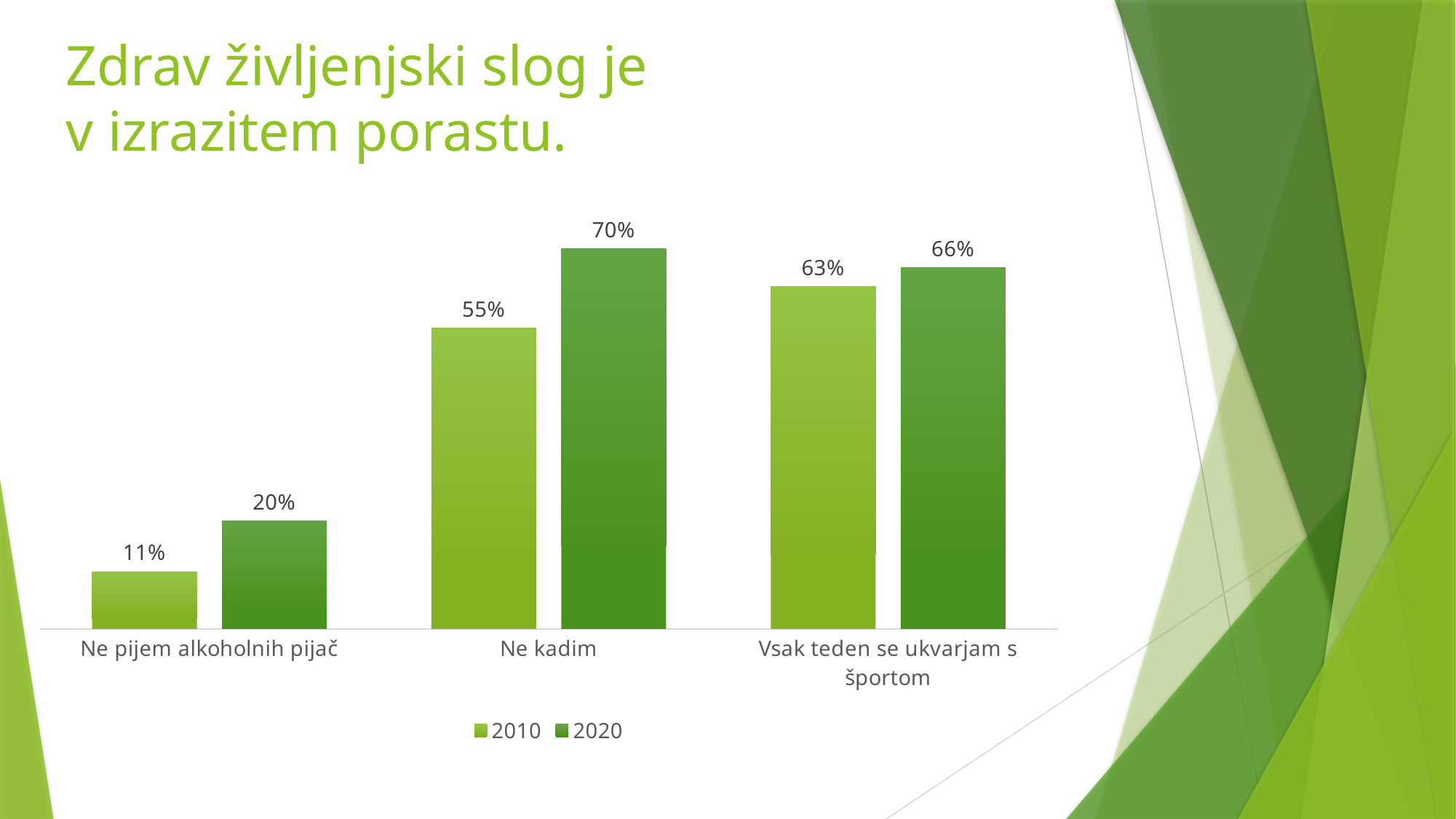
What is the value for 'Vsak teden se ukvarjam s športom' in 2010? 63% How many series does the legend list? 2 What is the value for 'Ne kadim' in 2020? 70% What is the difference between the 2020 and 2010 values for 'Ne kadim'? 15% What is the difference between the 2020 and 2010 values for 'Ne pijem alkoholnih pijač'? 9% What are the two series listed in the legend? 2010 and 2020 How many categories are shown on the x axis? 3 What kind of chart is shown on the slide? Bar chart What is the value for 'Ne pijem alkoholnih pijač' in 2010? 11% Which category has the highest value in 2020? Ne kadim Which category has the lowest value in 2010? Ne pijem alkoholnih pijač Which is larger for 'Vsak teden se ukvarjam s športom': the 2010 value or the 2020 value? 2020